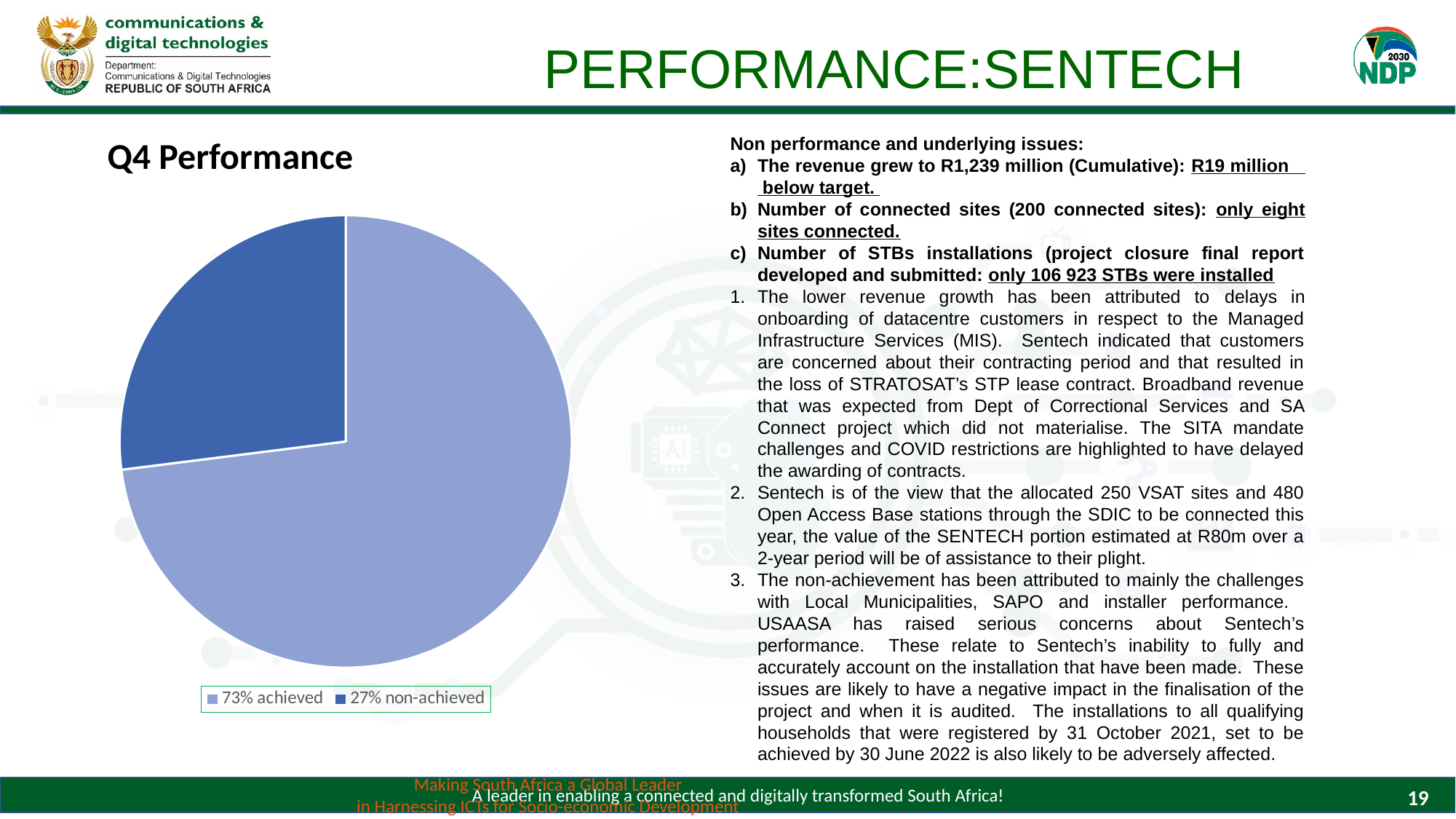
In the Q4 Performance pie chart, which is larger: the achieved slice or the non-achieved slice? achieved What is the title shown above the pie chart? Q4 Performance What is the difference in percentage points between the achieved and non-achieved slices in the Q4 Performance pie chart? 46 Which slice of the Q4 Performance pie chart is the largest? 73% achieved What share of the Q4 Performance pie is labelled as non-achieved? 27% Which slice of the Q4 Performance pie chart is the smallest? 27% non-achieved What share of the Q4 Performance pie is labelled as achieved? 73% Which legend entry in the Q4 Performance pie chart is shown in the darker blue colour? 27% non-achieved How many slices does the Q4 Performance pie chart have? 2 How many entries does the legend of the Q4 Performance pie chart list? 2 What kind of chart is shown under the heading 'Q4 Performance'? pie chart